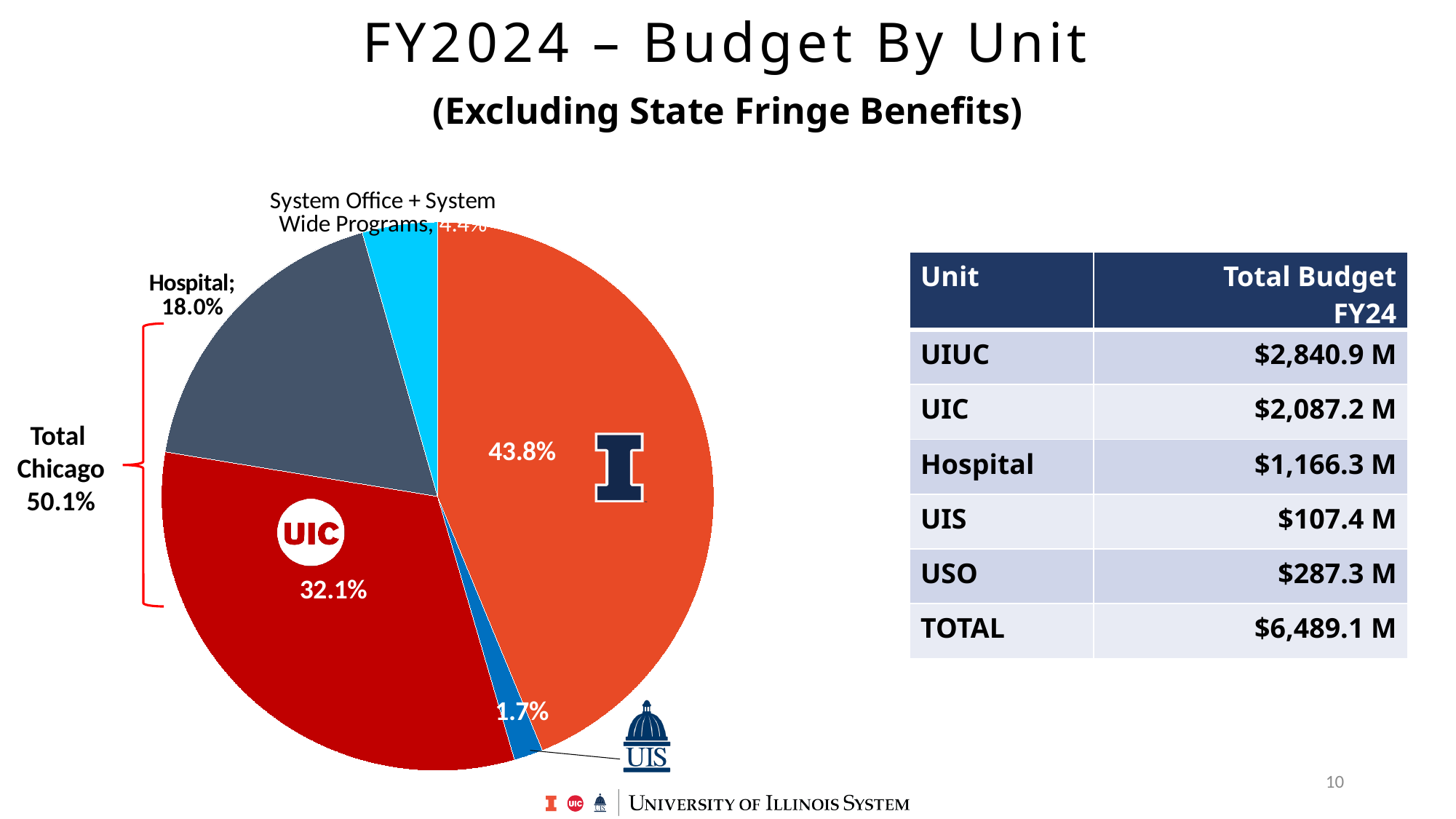
What percentage is shown for Total Chicago, the bracketed group of the UIC and Hospital slices? 50.1% Which slice of the pie is the smallest? UIS What share of the pie does the Hospital slice represent? 18.0% What is the difference in percentage points between the UIC slice and the Hospital slice? 14.1 Which slice is larger, Hospital or UIC? UIC What kind of chart is shown on the slide? pie chart What share of the pie does the System Office + System Wide Programs slice represent? 4.4% What share of the pie does the UIS slice represent? 1.7% What colour is the Hospital slice of the pie? gray How many slices does the pie chart have? 5 What percentage is shown on the largest slice of the pie? 43.8%